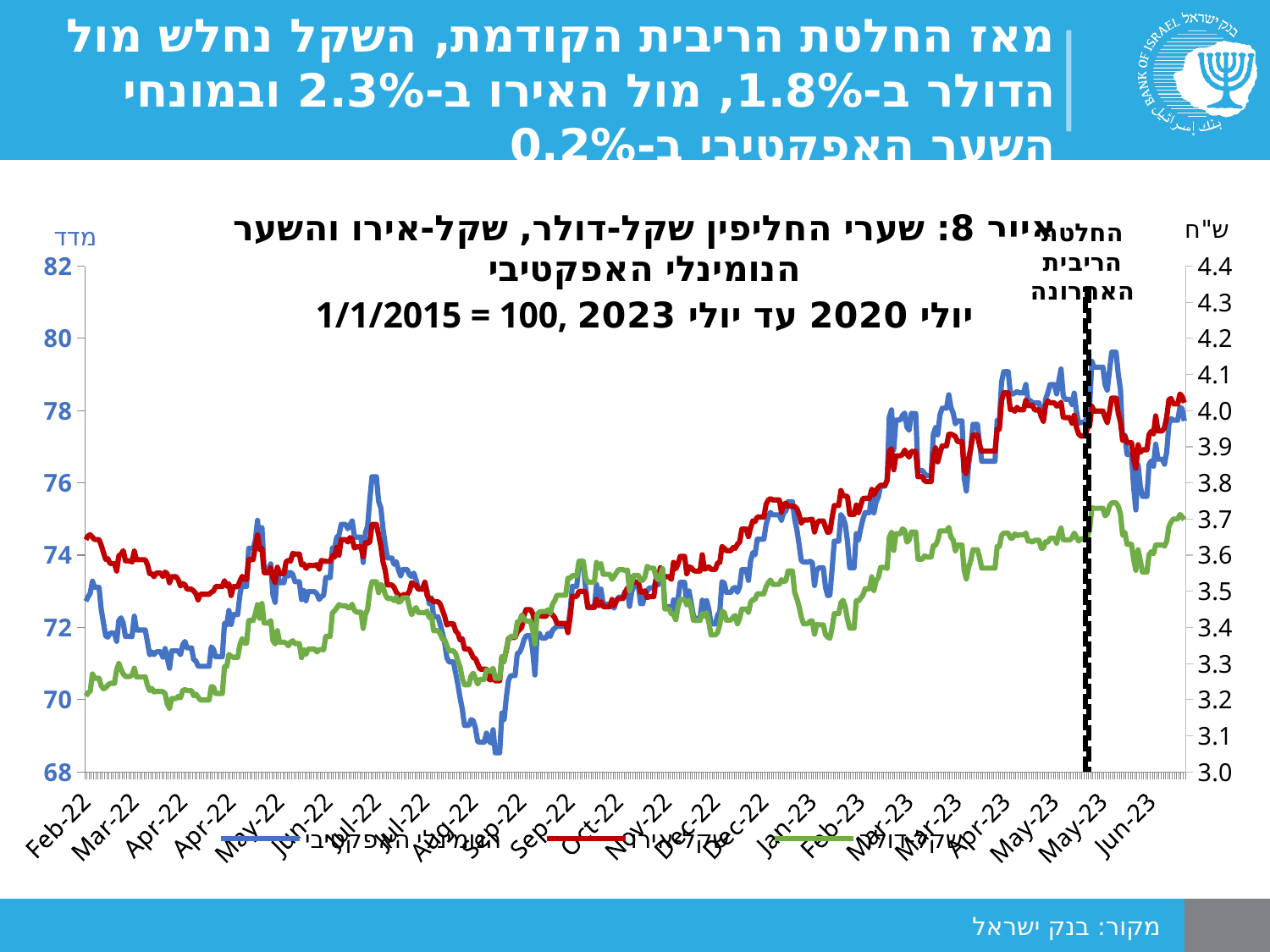
What kind of chart is shown on the slide? line chart Is the value of the red line (shekel/euro) at Feb-22 greater or less than 3.5 on the right axis? greater Is the value of the green line (shekel/dollar) at Feb-22 greater or less than 3.4 on the right axis? less How many data series (lines) are plotted on the chart? 3 Is the highest point of the blue line (nominal effective exchange rate), reached around May-23, greater or less than 78 on the left axis? greater What is the highest value shown on the right vertical axis of the chart? 4.4 Overall, does the blue line (nominal effective exchange rate) rise or fall from Feb-22 to Jun-23? rise Overall, does the green line (shekel/dollar) rise or fall from Feb-22 to Jun-23? rise What event does the vertical dashed black line on the chart mark? החלטת הריבית האחרונה (the last interest rate decision) What is the lowest value shown on the left vertical axis of the chart? 68